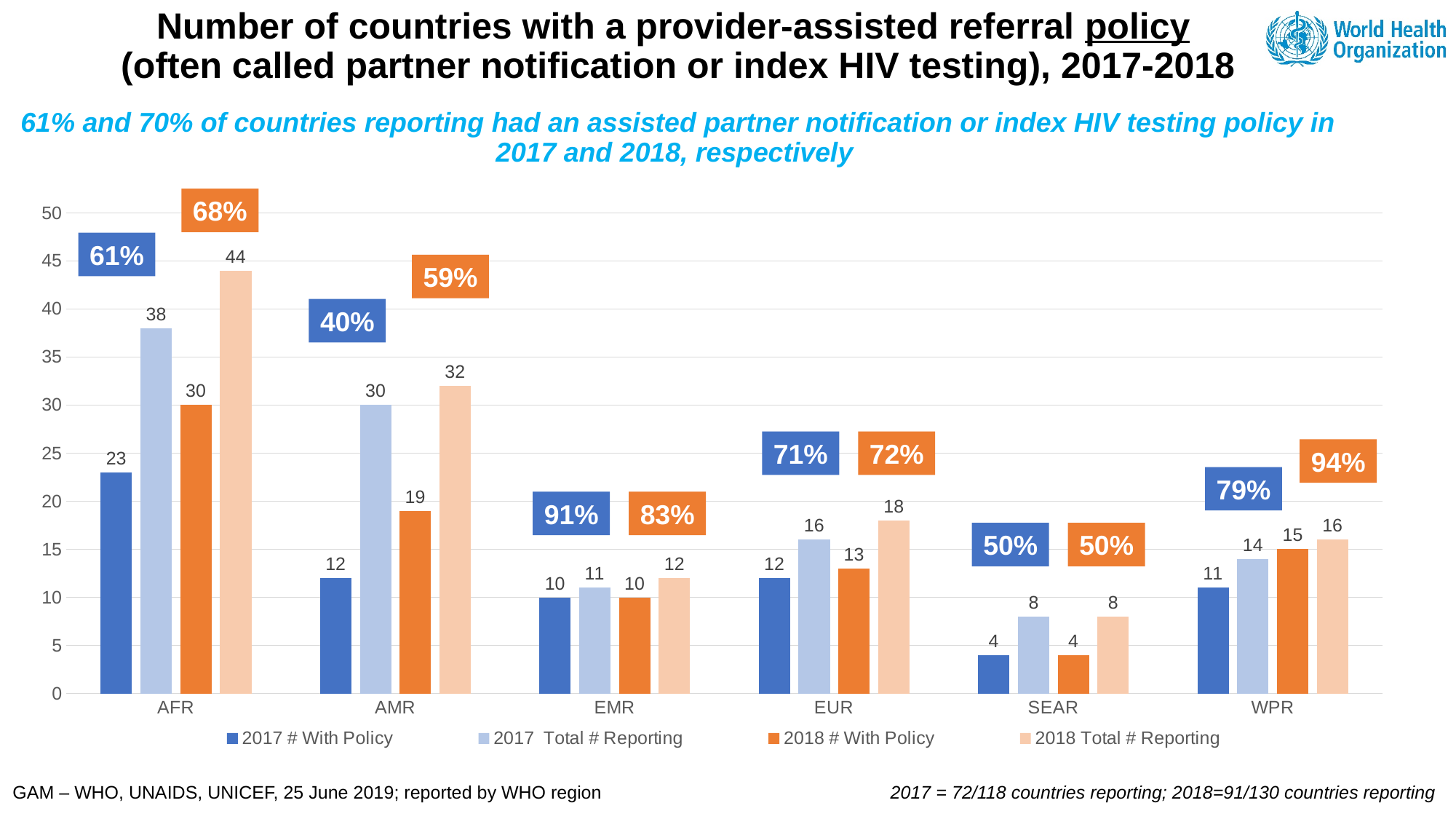
What is the 2017 # With Policy value for AFR? 23 Which region has the highest 2018 Total # Reporting value? AFR What percentage label is shown for EMR in 2017? 91% Which is larger for WPR: the 2017 # With Policy value or the 2018 # With Policy value? 2018 # With Policy What kind of chart is shown on the slide? Bar chart What is the 2018 # With Policy value for EUR? 13 How many regions are shown on the x axis? 6 Which region has the lowest 2017 # With Policy value? SEAR How many series does the legend list? 4 What is the difference between the 2018 Total # Reporting and the 2018 # With Policy values for AFR? 14 What percentage label is shown for WPR in 2018? 94% What is the 2018 Total # Reporting value for AMR? 32